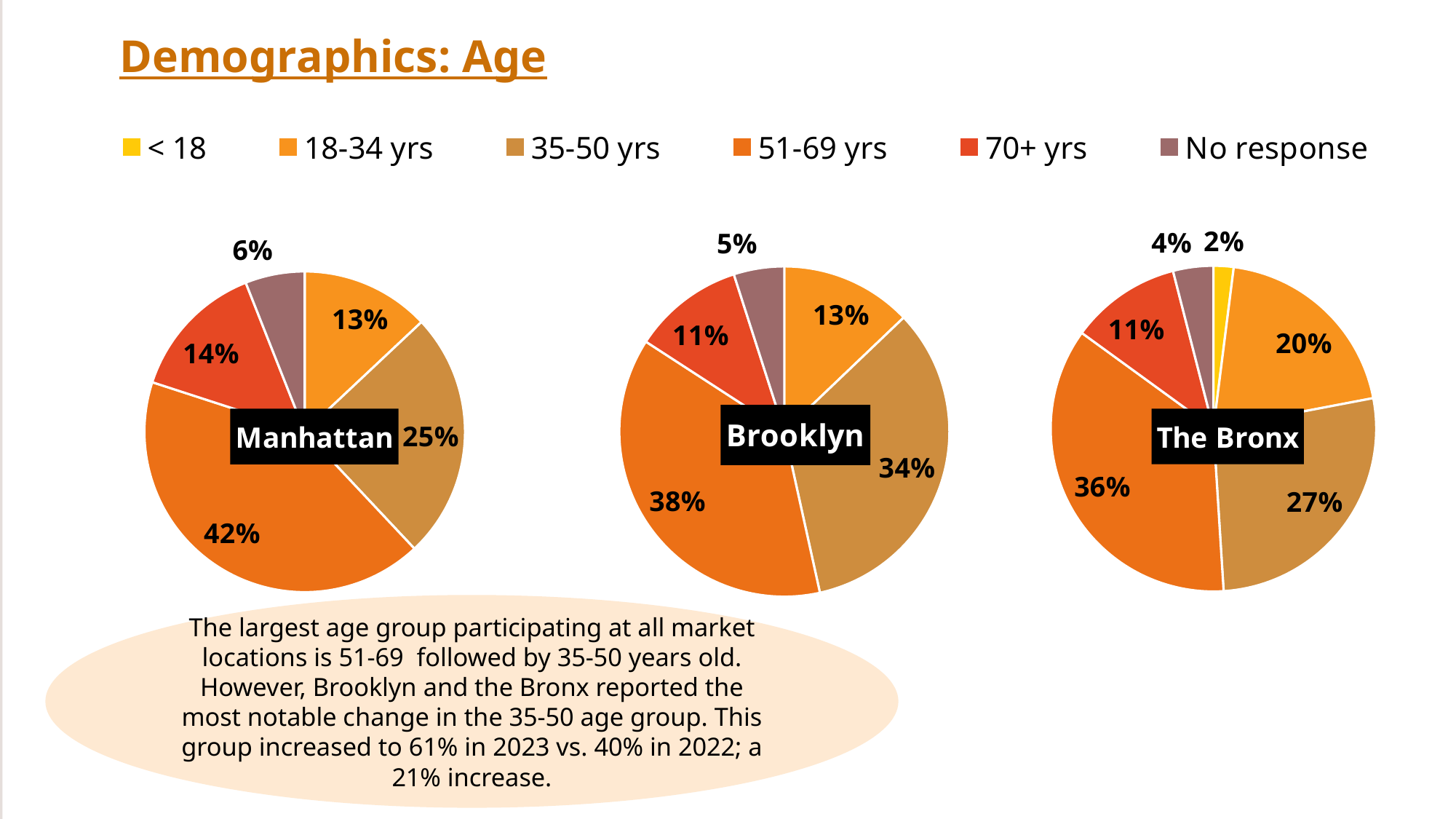
How many series does the legend list? 6 In the Brooklyn pie chart, what is the difference between the 51-69 yrs share and the 70+ yrs share? 27 percentage points In the Brooklyn pie chart, which group has the smallest share? No response In The Bronx pie chart, what share is the 18-34 yrs group? 20% In the Brooklyn pie chart, what share is the 35-50 yrs group? 34% In the Manhattan pie chart, what is the difference between the 51-69 yrs share and the 35-50 yrs share? 17 percentage points In The Bronx pie chart, which is larger: the 35-50 yrs share or the 18-34 yrs share? 35-50 yrs What kind of charts are shown on the slide? Pie charts In the Manhattan pie chart, what share is the 51-69 yrs group? 42% In The Bronx pie chart, what share is the < 18 group? 2% How many pie charts are on the slide? 3 In the Manhattan pie chart, which age group has the largest share? 51-69 yrs